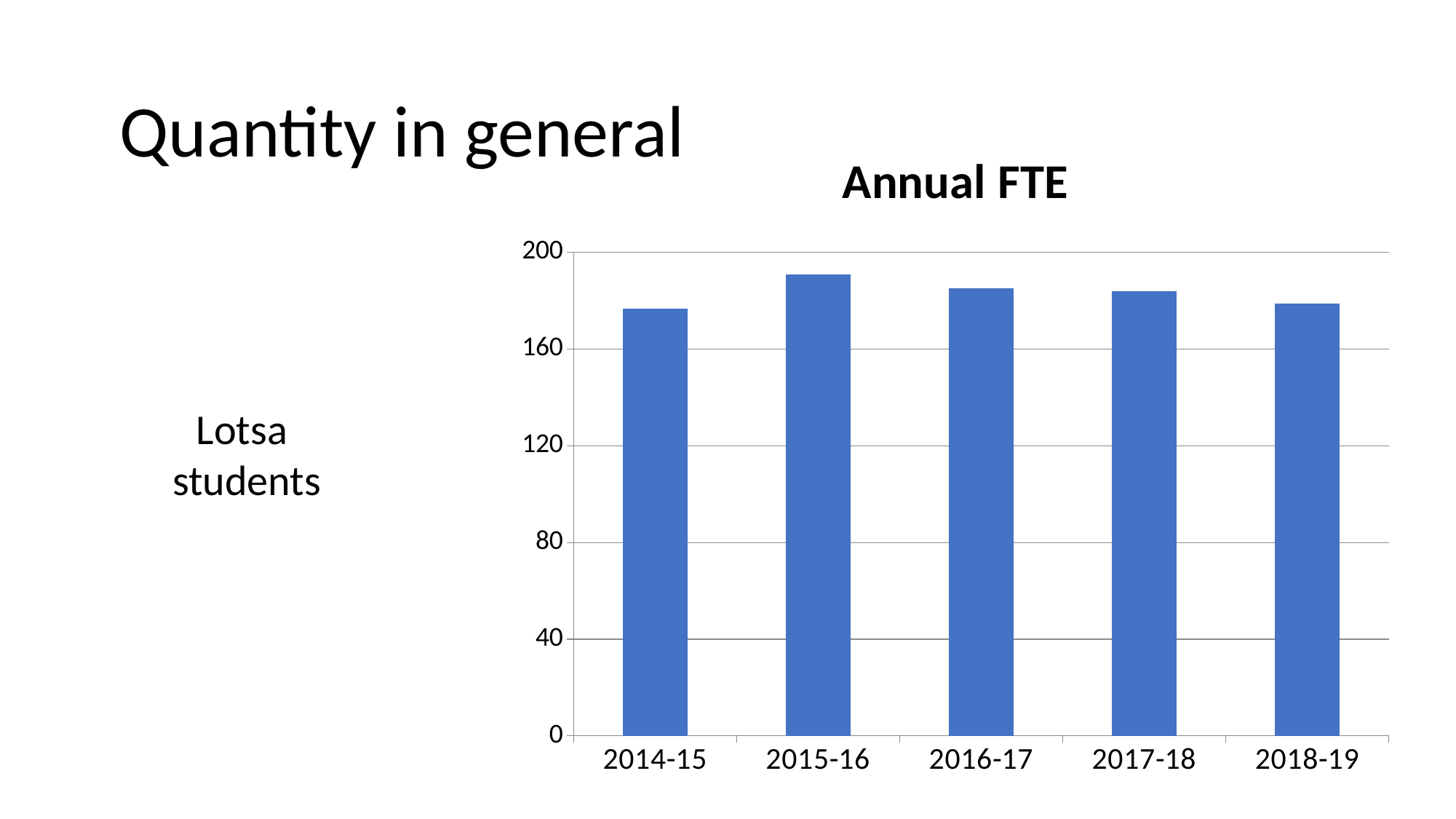
What kind of chart is shown on the slide? bar chart Is the Annual FTE for 2016-17 greater or less than 120? greater What is the highest value labelled on the vertical axis of the chart? 200 Is the Annual FTE for 2014-15 greater or less than 160? greater How many academic years are shown on the x axis of the chart? 5 Which is larger, the Annual FTE for 2015-16 or for 2014-15? 2015-16 What is the title of the chart? Annual FTE Is the Annual FTE for 2018-19 greater or less than 160? greater Which is larger, the Annual FTE for 2016-17 or for 2018-19? 2016-17 Does the Annual FTE rise or fall from 2015-16 to 2018-19? fall Which year has the highest Annual FTE? 2015-16